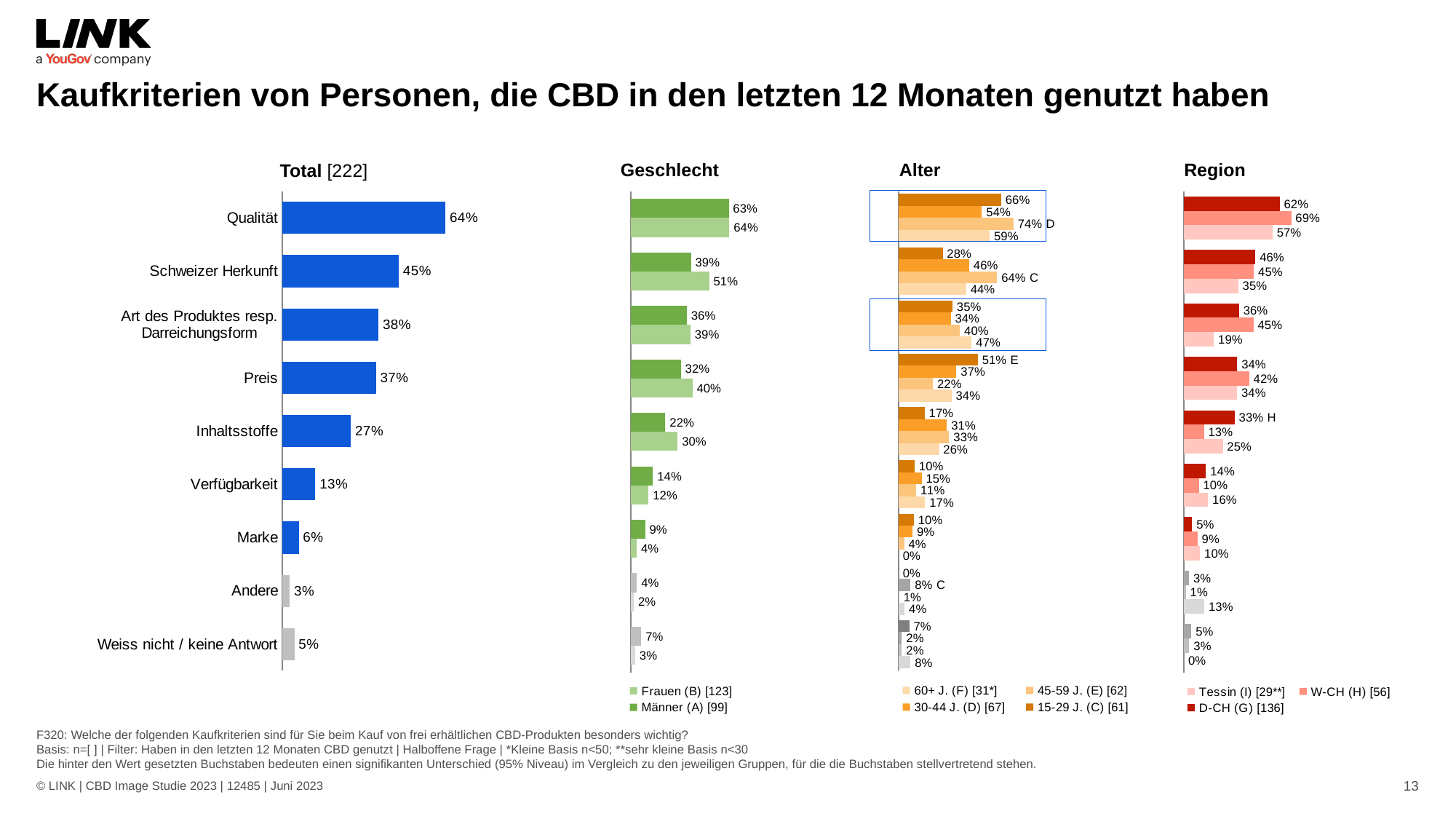
In the Geschlecht chart, which is larger for Preis: Männer (A) or Frauen (B)? Frauen (B) In the Alter chart, which age group has the highest value for Preis? 15-29 J. (C) What type of chart is the Total chart? Bar chart In the Region chart, what is the difference between W-CH (H) and D-CH (G) for Inhaltsstoffe? 20 percentage points In the Geschlecht chart, what is the value for Frauen (B) for Schweizer Herkunft? 51% In the Total chart, how many categories are shown? 9 How many series does the legend of the Alter chart list? 4 In the Region chart, what is the value for Tessin (I) for Art des Produktes resp. Darreichungsform? 19% In the Total chart, what is the value for Qualität? 64% In the Total chart, what is the difference between Schweizer Herkunft and Preis? 8 percentage points In the Alter chart, what is the value for 30-44 J. (D) for Qualität? 54% In the Total chart, which category has the highest value? Qualität